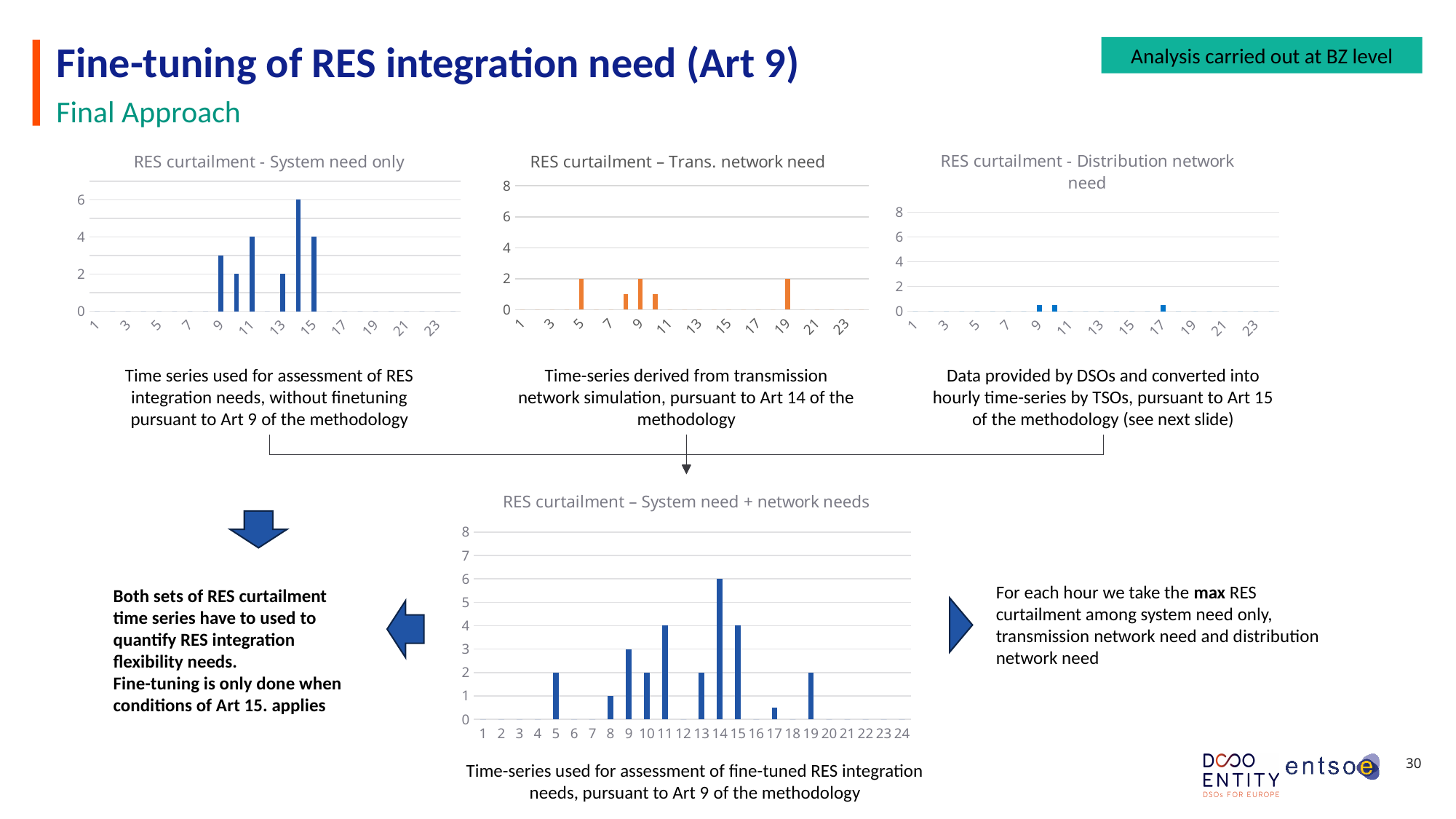
How many hours are labelled on the x axis of the 'RES curtailment – System need + network needs' chart? 24 What colour are the bars in the 'RES curtailment – Trans. network need' chart? orange In the 'RES curtailment – System need + network needs' chart, what is the value at hour 14? 6 In the 'RES curtailment – System need + network needs' chart, which is larger, the value at hour 9 or at hour 10? hour 9 In the 'RES curtailment – System need + network needs' chart, what is the value at hour 9? 3 What kind of chart is the 'RES curtailment – System need + network needs' chart? bar chart In the 'RES curtailment - Distribution network need' chart, is the value at hour 9 greater or less than 2? less In the 'RES curtailment - System need only' chart, what is the value at hour 14? 6 In the 'RES curtailment – System need + network needs' chart, what is the difference between the values at hour 14 and hour 11? 2 In the 'RES curtailment – System need + network needs' chart, which hour has the highest value? 14 In the 'RES curtailment - System need only' chart, which hour has the highest value? 14 In the 'RES curtailment – Trans. network need' chart, what is the value at hour 5? 2